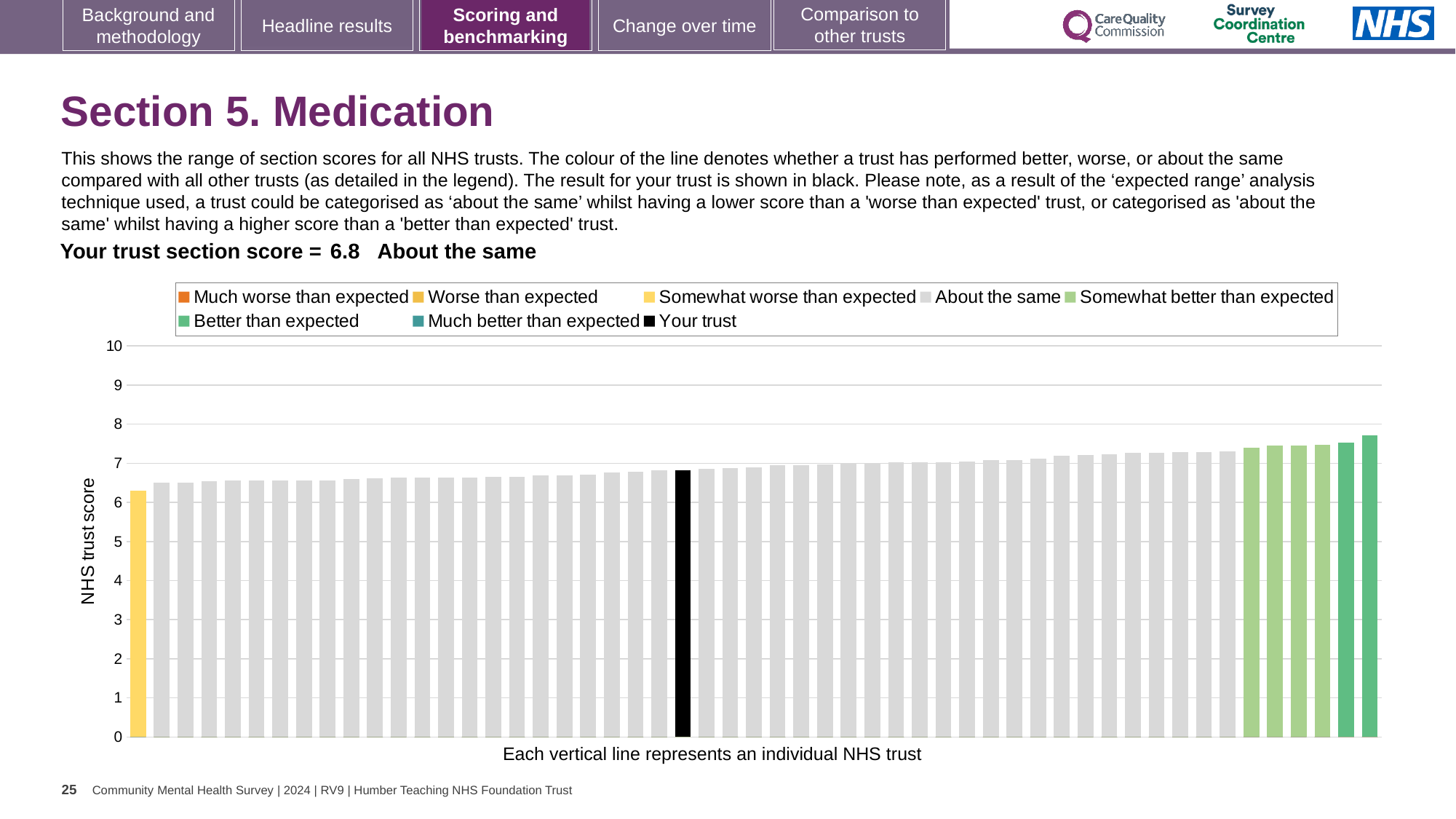
Is the value for your trust (the black bar) greater or less than 5? greater Is the value of the rightmost bar greater or less than 8? less What is the label on the vertical axis of the chart? NHS trust score Which legend category does the lowest bar on the chart belong to? Somewhat worse than expected Is the value of the leftmost (yellow) bar greater or less than 7? less What is the section score for your trust shown on the slide? 6.8 What kind of chart is shown on the slide? bar chart Which is higher: the black bar for your trust or the yellow bar at the far left? the black bar (your trust) Do the bar values rise or fall from left to right along the x axis? rise How many entries does the chart legend list? 8 Which legend category does the highest bar on the chart belong to? Better than expected